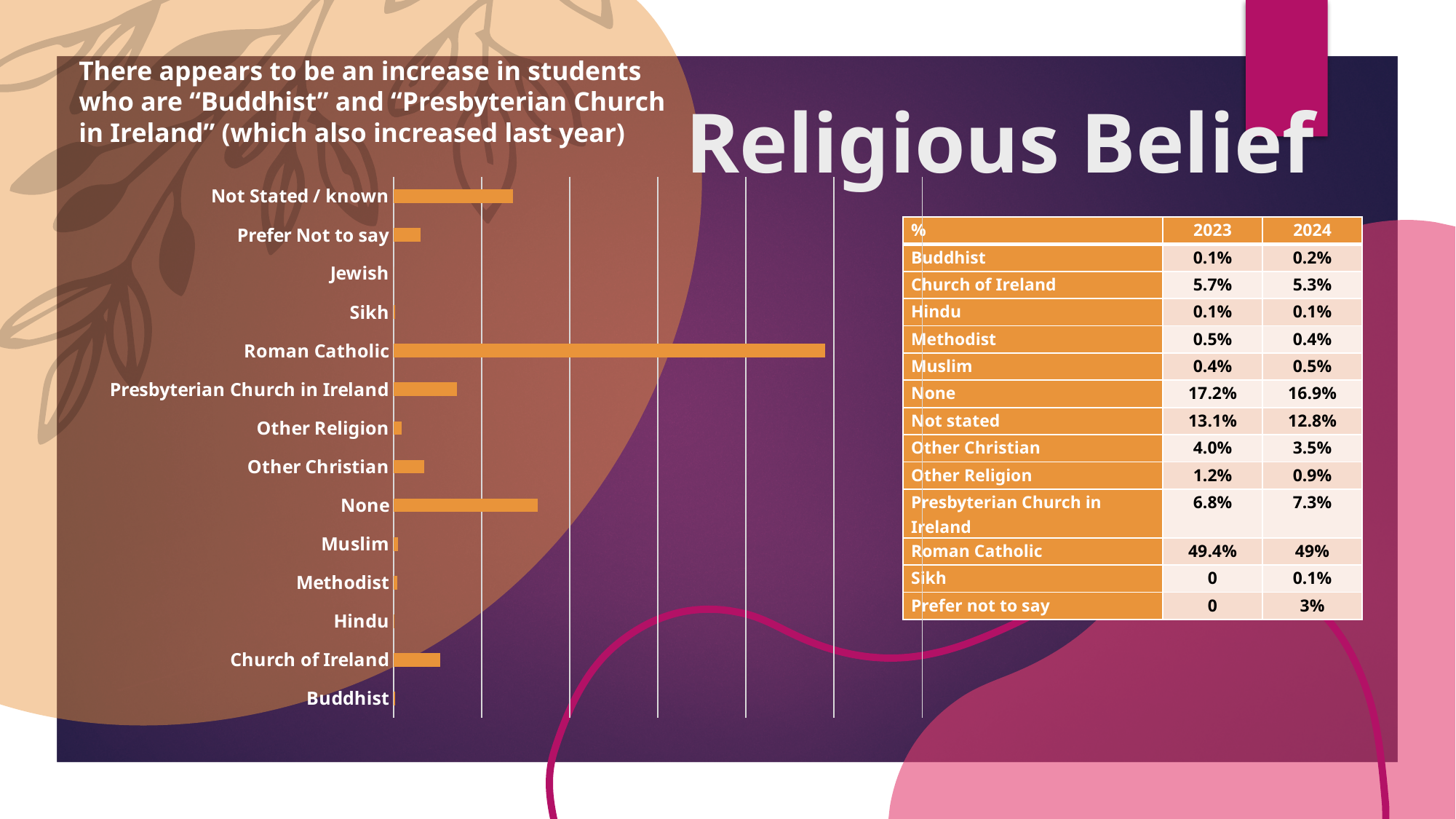
Which bar is longer on the chart, Roman Catholic or None? Roman Catholic What colour are the bars on the chart? Orange Which bar is longer on the chart, Presbyterian Church in Ireland or Church of Ireland? Presbyterian Church in Ireland Which bar is longer on the chart, None or Not Stated / known? None How many categories are listed on the bar chart? 14 Which category has the second longest bar on the chart? None Which category has the longest bar on the chart? Roman Catholic What kind of chart is shown on the slide? Bar chart Are the bars on the chart horizontal or vertical? Horizontal